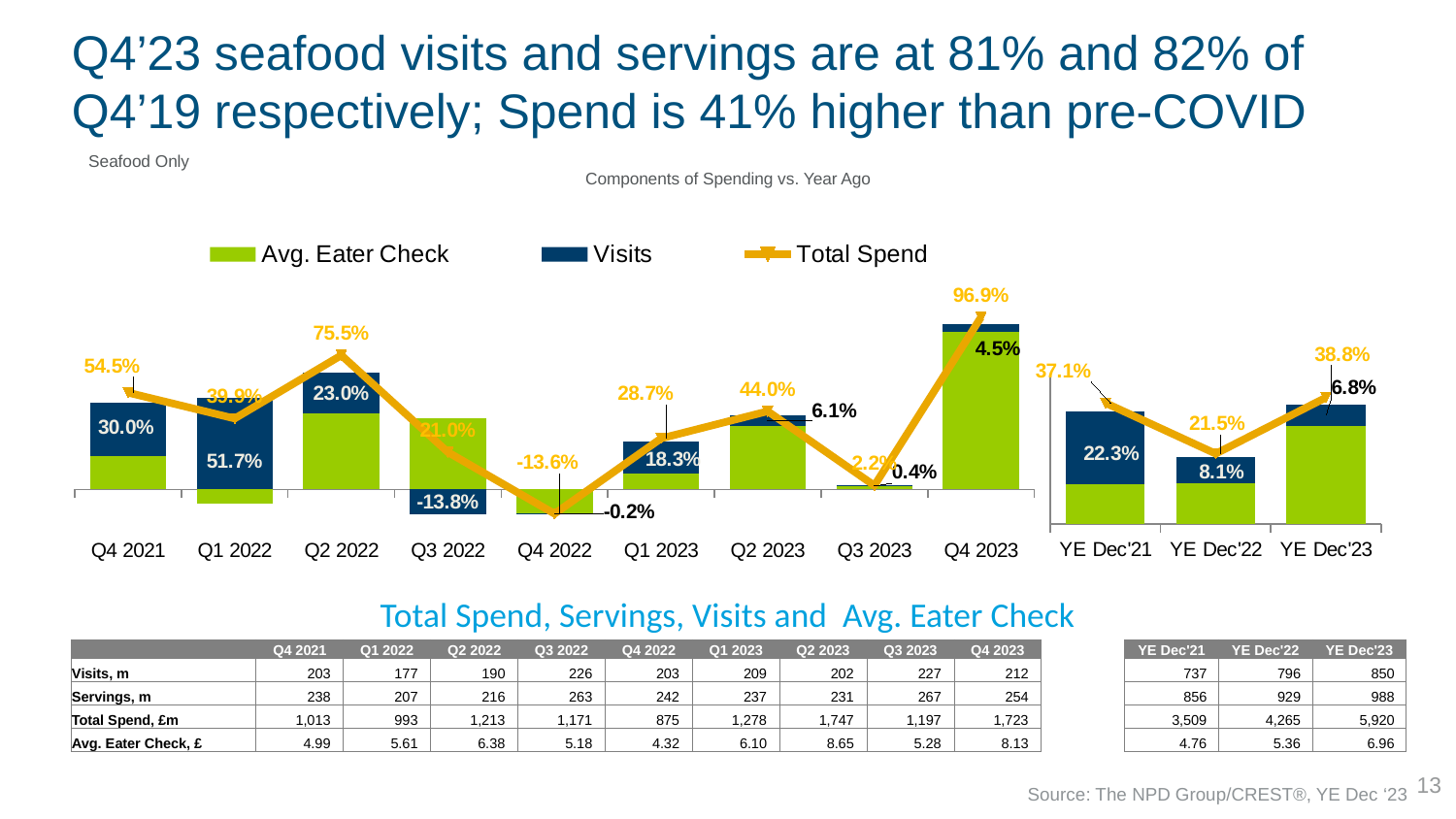
In the Components of Spending vs. Year Ago chart, what is the Total Spend value for Q4 2023? 96.9% In the Components of Spending vs. Year Ago chart, which has the higher Total Spend value, Q1 2023 or Q2 2023? Q2 2023 In the Components of Spending vs. Year Ago chart, which quarter has the highest Total Spend value? Q4 2023 How many quarterly categories (Q4 2021 through Q4 2023) are shown in the Components of Spending vs. Year Ago chart? 9 How many series does the legend of the Components of Spending vs. Year Ago chart list? 3 In the Components of Spending vs. Year Ago chart, what is the difference between the Total Spend values for Q2 2022 and Q1 2022? 35.6 percentage points In the Components of Spending vs. Year Ago chart, what is the Visits value for Q1 2022? 51.7% In the Components of Spending vs. Year Ago chart, what is the Total Spend value for Q4 2022? -13.6% In the Components of Spending vs. Year Ago chart, which quarter has the lowest Visits value? Q3 2022 In the Components of Spending vs. Year Ago chart, what is the Visits value for YE Dec'23? 6.8% In the Components of Spending vs. Year Ago chart, which quarter has the lowest Total Spend value? Q4 2022 What colour represents Avg. Eater Check in the Components of Spending vs. Year Ago chart? Green